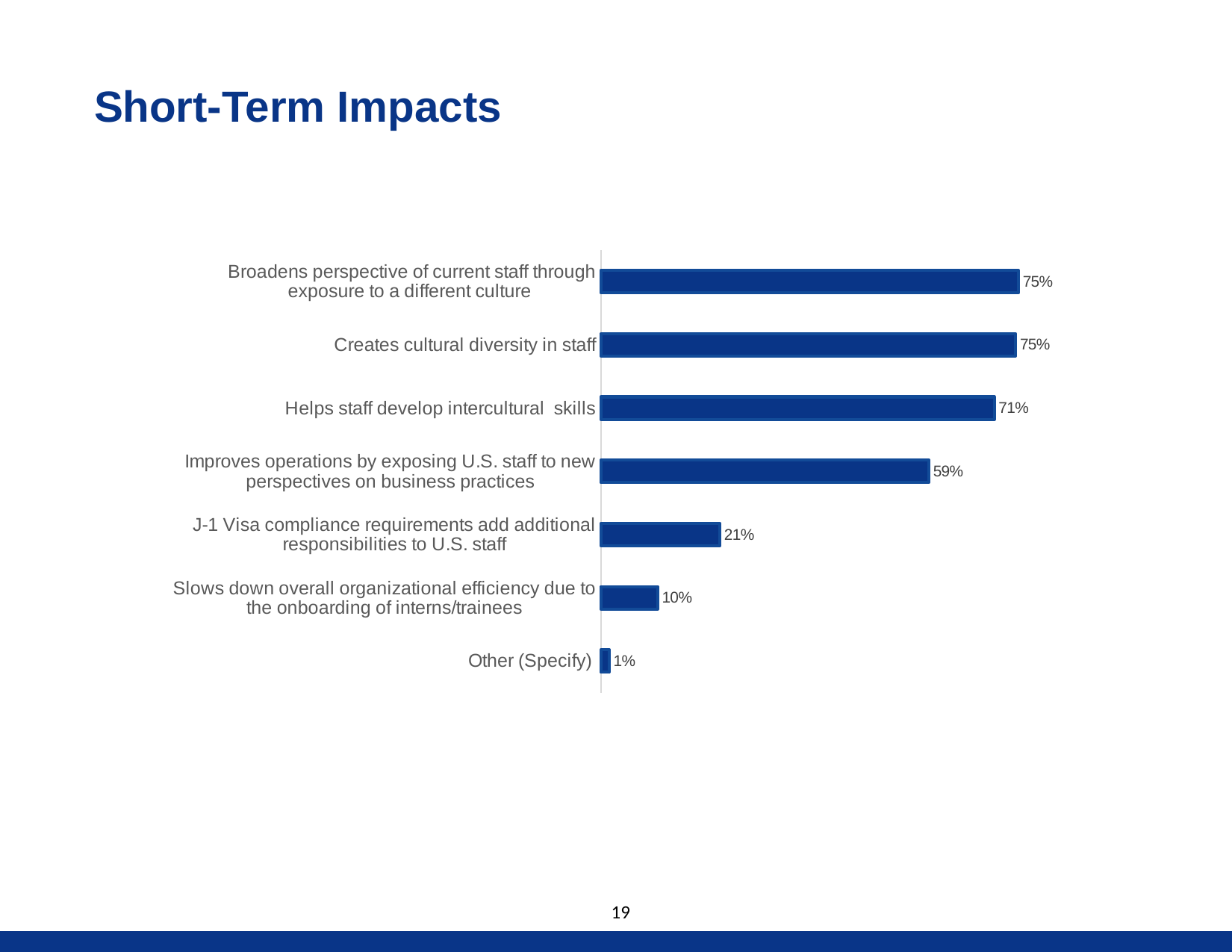
Which is larger: the value for "Creates cultural diversity in staff" or the value for "Helps staff develop intercultural skills"? Creates cultural diversity in staff What is the value for "Helps staff develop intercultural skills"? 71% What kind of chart is shown on the slide? Bar chart What percentage is shown for "Slows down overall organizational efficiency due to the onboarding of interns/trainees"? 10% What is the title of the slide? Short-Term Impacts What percentage is shown for "Creates cultural diversity in staff"? 75% What is the difference between the values for "Helps staff develop intercultural skills" and "Improves operations by exposing U.S. staff to new perspectives on business practices"? 12% What percentage is shown for "Improves operations by exposing U.S. staff to new perspectives on business practices"? 59% Which category has the lowest value? Other (Specify) How many categories are shown in the chart? 7 What is the value for "J-1 Visa compliance requirements add additional responsibilities to U.S. staff"? 21% What is the difference between the values for "J-1 Visa compliance requirements add additional responsibilities to U.S. staff" and "Slows down overall organizational efficiency due to the onboarding of interns/trainees"? 11%